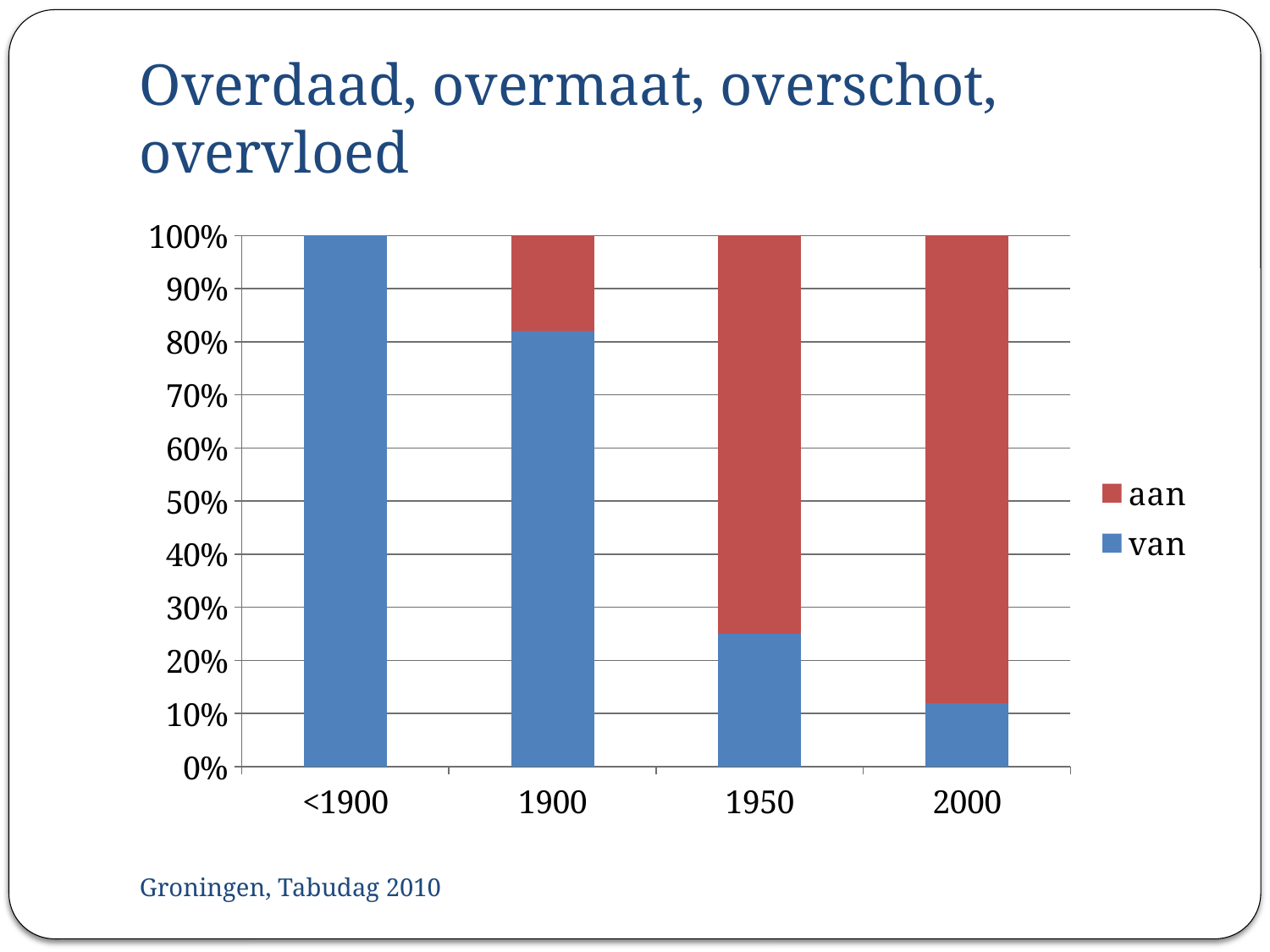
What is the value of 'van' for the <1900 category? 100% How many categories are shown on the x axis? 4 Is the value of 'van' for 2000 greater or less than 20%? less Which category has the highest share of 'aan'? 2000 Which colour represents the 'aan' series in the legend? red Which category has the lowest share of 'van'? 2000 Is the value of 'van' for 1900 greater or less than 70%? greater How many series does the legend list? 2 Is the value of 'van' for 1950 greater or less than 30%? less What kind of chart is shown on the slide? stacked bar chart Which is larger for 1950: the share of 'aan' or the share of 'van'? aan Does the share of 'van' rise or fall from <1900 to 2000? fall